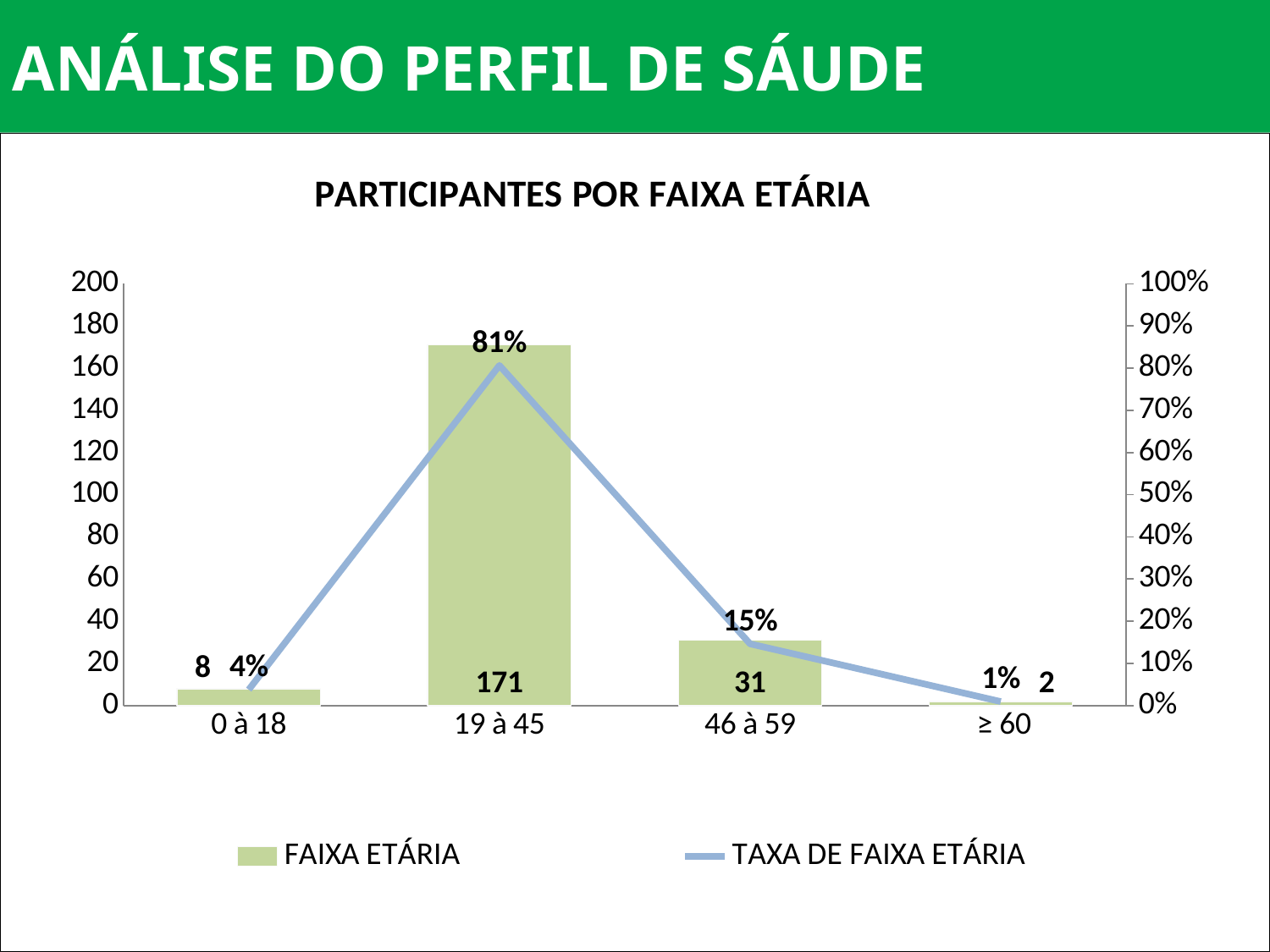
How many series does the legend list? 2 What is the TAXA DE FAIXA ETÁRIA value for the 0 à 18 age group? 4% What is the title of the chart? PARTICIPANTES POR FAIXA ETÁRIA What is the TAXA DE FAIXA ETÁRIA value for the 46 à 59 age group? 15% What is the total number of participants across all four age groups? 212 What is the number of participants for the ≥ 60 age group? 2 What is the difference in participants between the 19 à 45 and 46 à 59 age groups? 140 Which age group has the lowest TAXA DE FAIXA ETÁRIA? ≥ 60 What is the number of participants (FAIXA ETÁRIA) for the 19 à 45 age group? 171 Which age group has more participants, 0 à 18 or 46 à 59? 46 à 59 How many age groups are shown on the x axis? 4 Which age group has the highest number of participants? 19 à 45